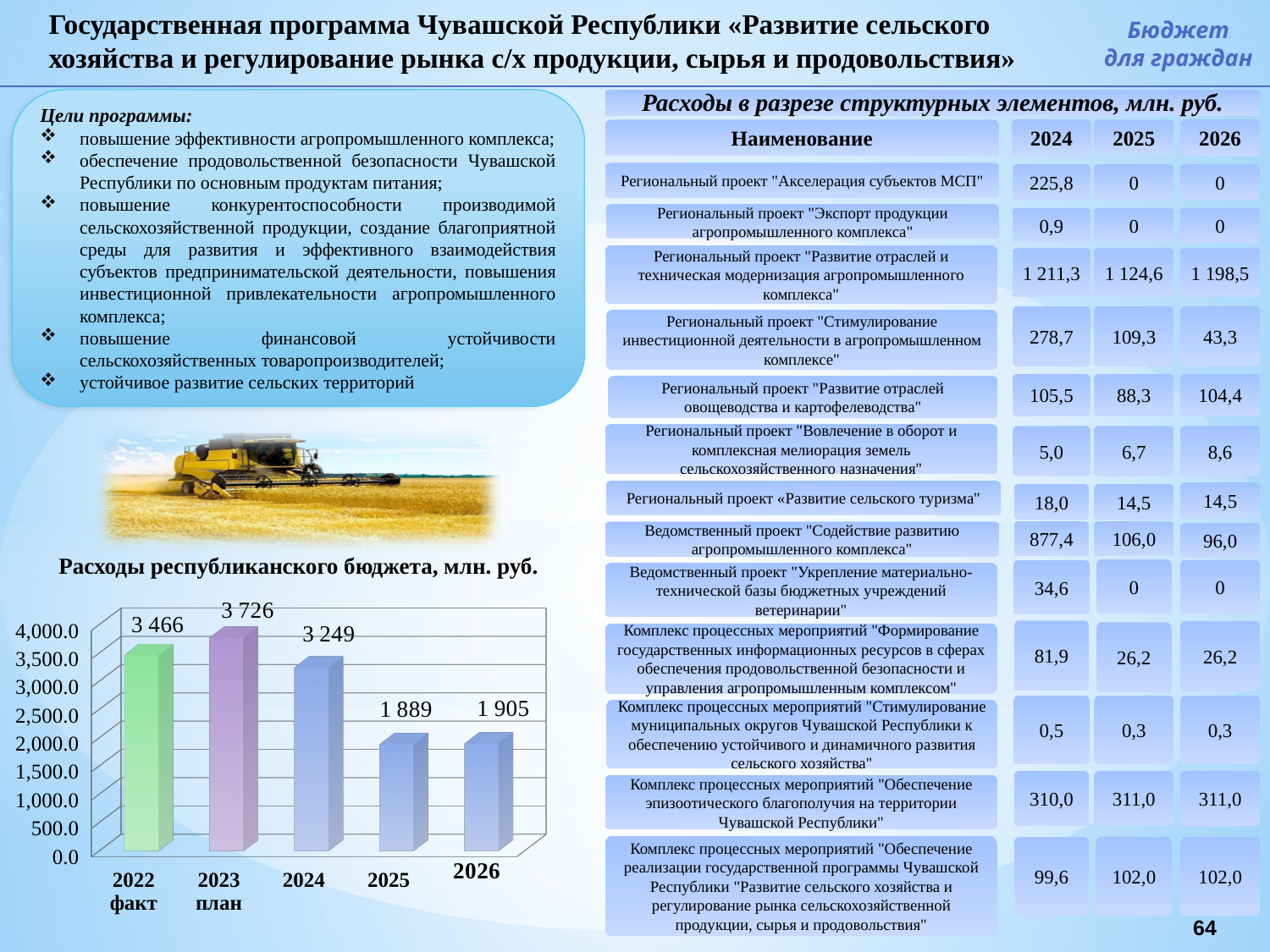
In the chart "Расходы республиканского бюджета, млн. руб.", do the values rise or fall from 2023 план to 2025? fall What is the value for 2023 план in the chart "Расходы республиканского бюджета, млн. руб."? 3 726 In the chart "Расходы республиканского бюджета, млн. руб.", is the value for 2024 greater or less than 3,000.0? greater What type of chart is "Расходы республиканского бюджета, млн. руб."? bar chart What is the value for 2022 факт in the chart "Расходы республиканского бюджета, млн. руб."? 3 466 Which year has the lowest value in the chart "Расходы республиканского бюджета, млн. руб."? 2025 In the chart "Расходы республиканского бюджета, млн. руб.", what is the difference between the values for 2023 план and 2024? 477 What is the value for 2025 in the chart "Расходы республиканского бюджета, млн. руб."? 1 889 How many bars are shown in the chart "Расходы республиканского бюджета, млн. руб."? 5 In the chart "Расходы республиканского бюджета, млн. руб.", which is larger: the value for 2022 факт or the value for 2024? 2022 факт Which year has the highest value in the chart "Расходы республиканского бюджета, млн. руб."? 2023 план In the chart "Расходы республиканского бюджета, млн. руб.", what is the difference between the values for 2026 and 2025? 16